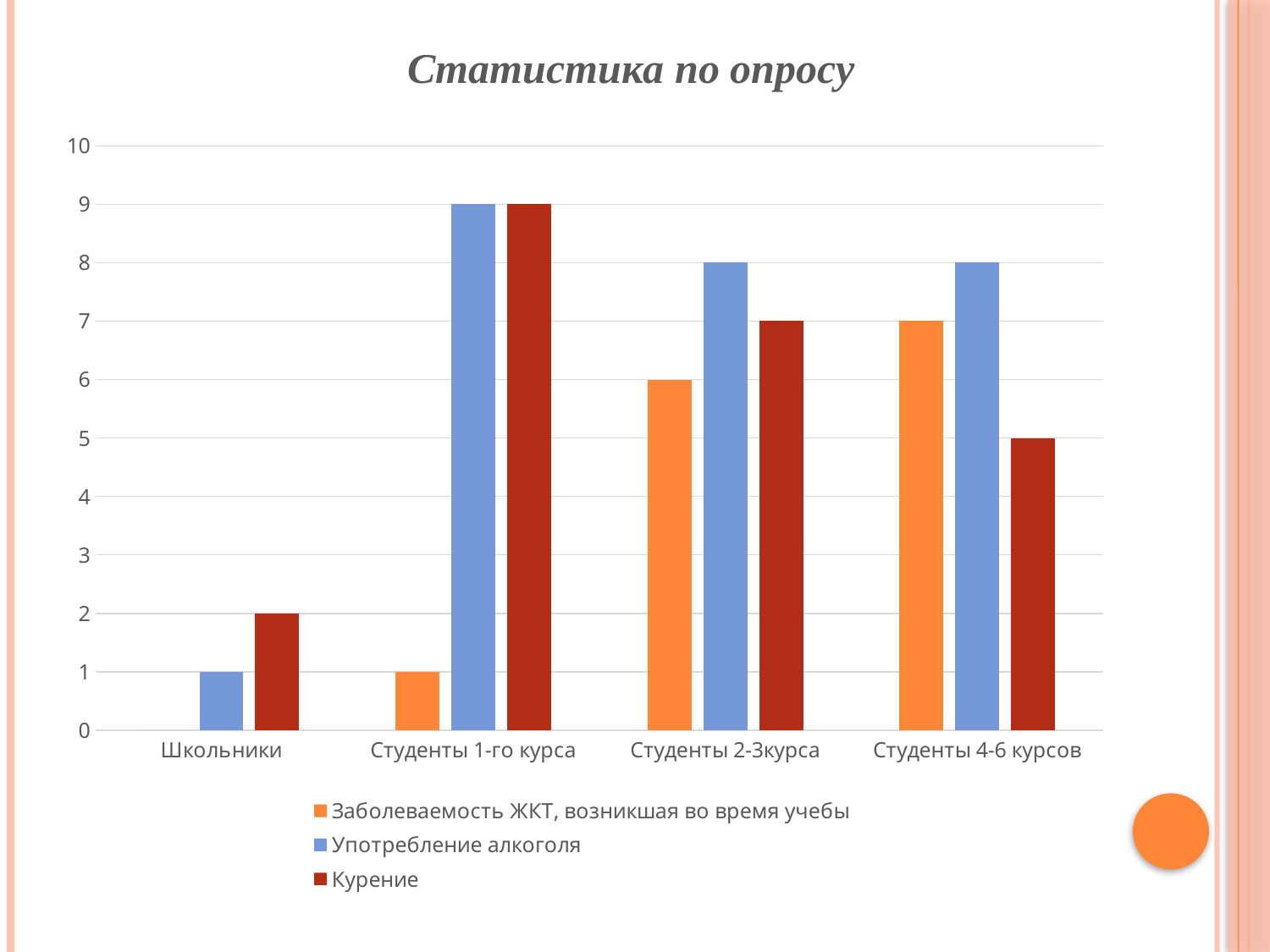
Which is larger for Студенты 2-3курса: Заболеваемость ЖКТ, возникшая во время учебы or Курение? Курение What is the difference between Употребление алкоголя and Курение for Студенты 4-6 курсов? 3 What kind of chart is shown on the slide? bar chart Which category has the highest value for Курение? Студенты 1-го курса What is the title of the chart? Статистика по опросу How many categories are shown on the x axis? 4 What is the value of Курение for Школьники? 2 What is the value of Заболеваемость ЖКТ, возникшая во время учебы for Студенты 4-6 курсов? 7 Which category has the lowest value for Употребление алкоголя? Школьники How many series does the legend list? 3 Does the value of Заболеваемость ЖКТ, возникшая во время учебы rise or fall from Школьники to Студенты 4-6 курсов? rise What is the value of Употребление алкоголя for Студенты 1-го курса? 9